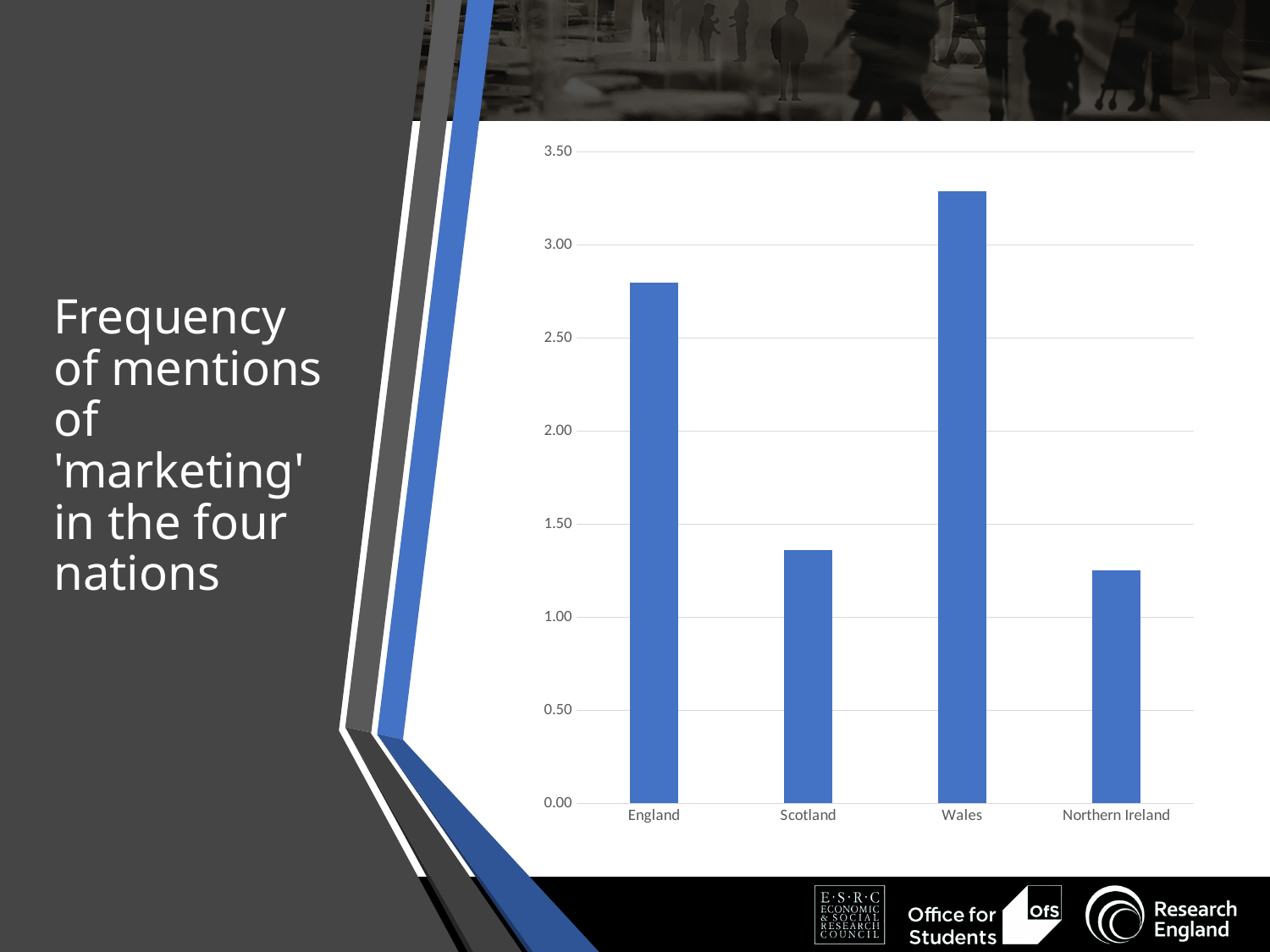
Is the value for England greater or less than 2.50? greater Is the value for England greater or less than 3.00? less What kind of chart is shown on the slide? bar chart Is the value for Northern Ireland greater or less than 1.50? less How many nations (categories) are plotted on the chart? 4 What is the title of the slide containing the chart? Frequency of mentions of 'marketing' in the four nations Which nation has the highest frequency of mentions of 'marketing'? Wales Which has the larger value, England or Scotland? England Which nation has the lowest frequency of mentions of 'marketing'? Northern Ireland Which has the larger value, Wales or Northern Ireland? Wales